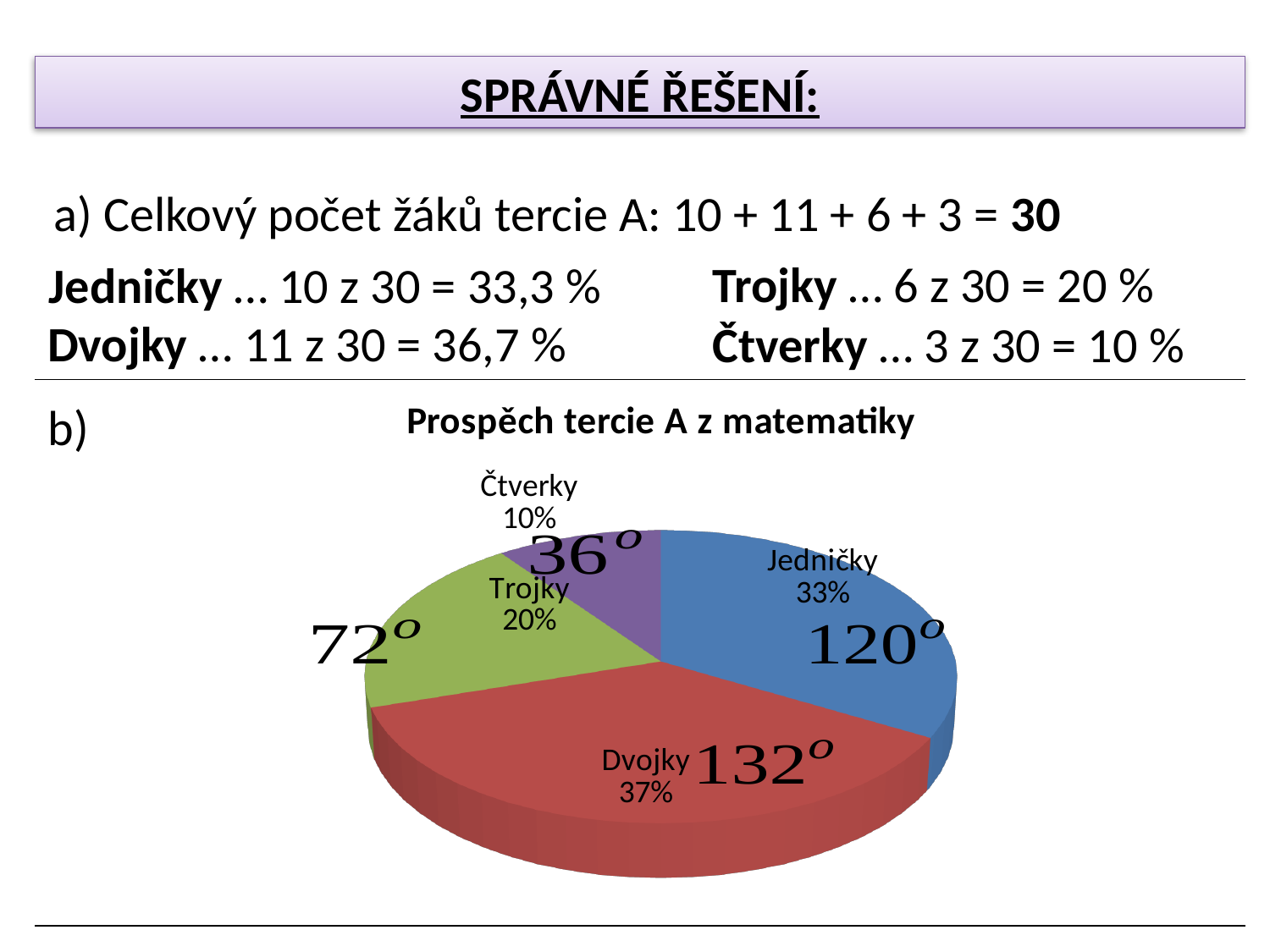
Which slice has the smallest share of the pie? Čtverky Which slice is larger, Trojky or Čtverky? Trojky What is the difference in percentage points between the Dvojky and Jedničky slices? 4 Which slice has the largest share of the pie? Dvojky What percentage is shown for the Čtverky slice? 10% What kind of chart is shown on the slide? pie chart What percentage is shown for the Trojky slice? 20% What angle in degrees is written next to the Dvojky slice? 132° What is the title of the chart? Prospěch tercie A z matematiky What percentage is shown for the Dvojky slice? 37% How many slices does the pie chart have? 4 What percentage is shown for the Jedničky slice? 33%